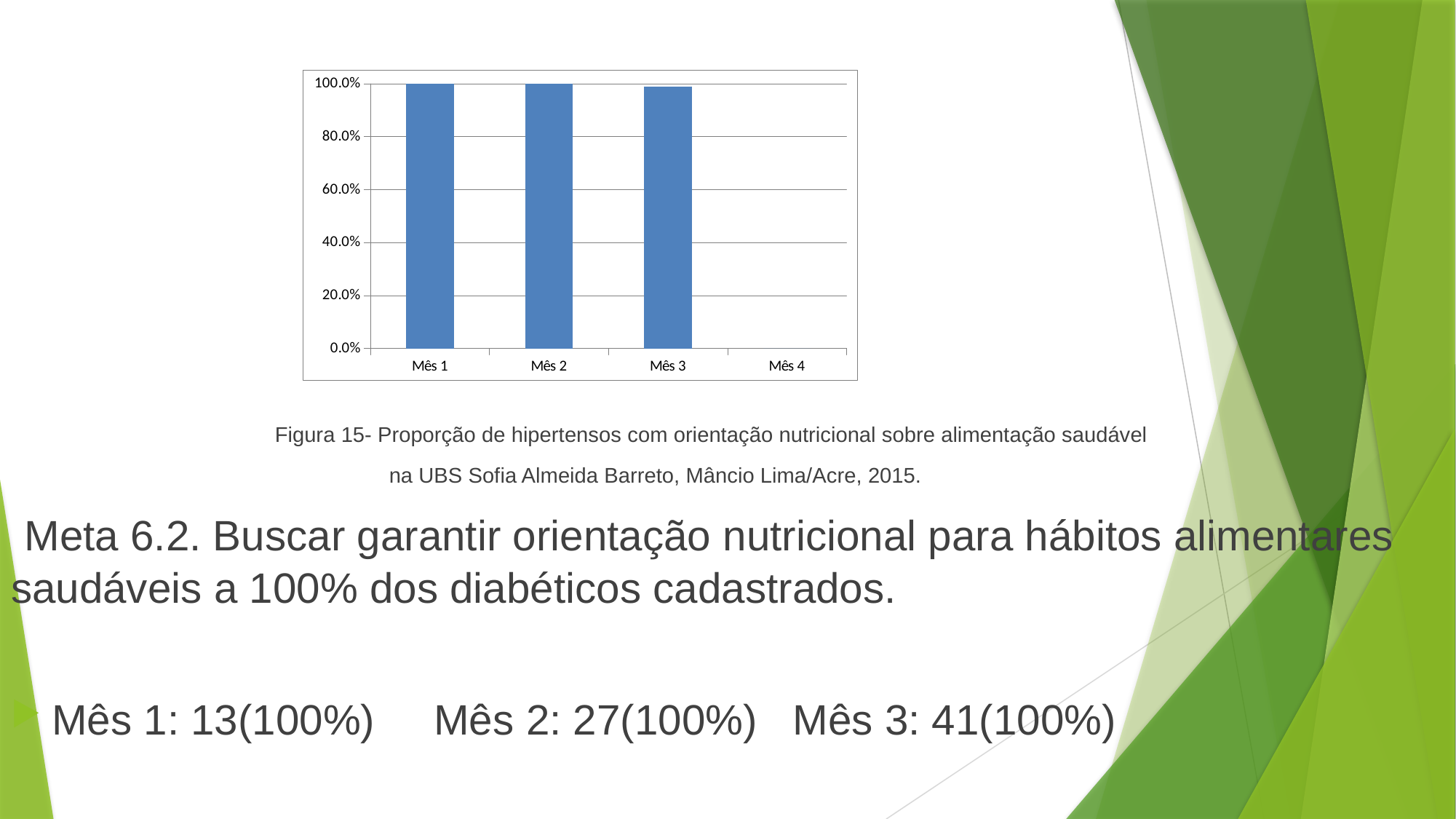
Does the value rise or fall from Mês 3 to Mês 4? fall Which is larger, the value for Mês 1 or the value for Mês 4? Mês 1 What is the value for Mês 2 in the chart? 100.0% Which category has the lowest value in the chart? Mês 4 What kind of chart is shown on the slide? bar chart What is the value for Mês 1 in the chart? 100.0% Is the value for Mês 3 greater or less than 80.0%? greater How many categories are shown on the x axis of the chart? 4 What figure number is given in the caption below the chart? Figura 15 Is the value for Mês 4 greater or less than 20.0%? less How many categories in the chart have a visible bar? 3 What colour are the bars in the chart? blue